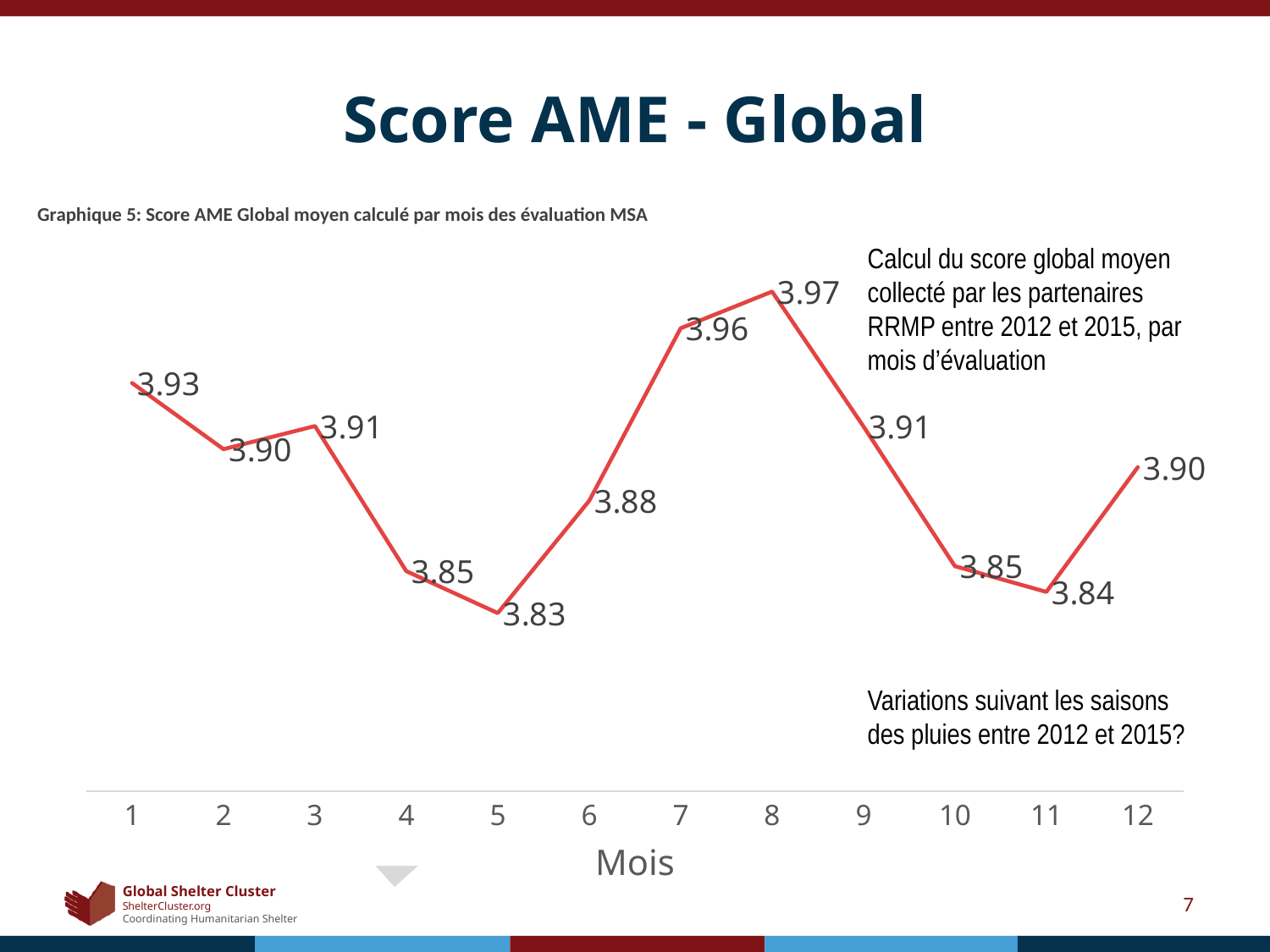
Does the value rise or fall from month 9 to month 10? fall Which month has the highest Score AME Global value? 8 What is the difference between the values for month 8 and month 5? 0.14 What is the Score AME Global value for month 1? 3.93 What is the Score AME Global value for month 12? 3.90 Which month has the lowest Score AME Global value? 5 What is the Score AME Global value for month 5? 3.83 Which has a larger value, month 7 or month 6? month 7 What is the label of the x axis? Mois What is the Score AME Global value for month 8? 3.97 How many months are plotted on the x axis? 12 What type of chart is shown on the slide? line chart